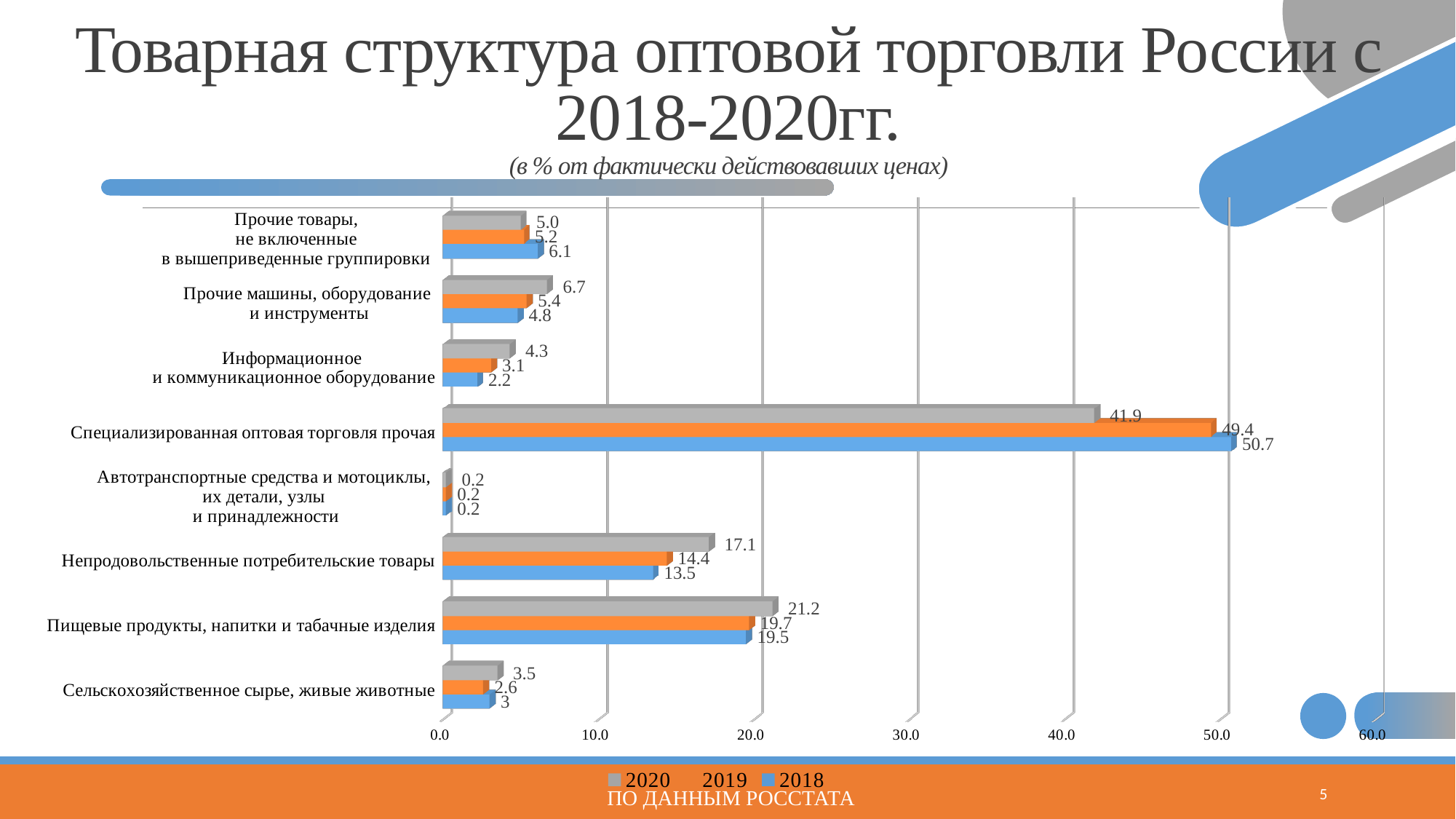
Which category has the highest 2018 value? Специализированная оптовая торговля прочая How many categories are shown on the chart? 8 What kind of chart is shown on the slide? Bar chart Which category has the lowest 2020 value? Автотранспортные средства и мотоциклы, их детали, узлы и принадлежности Is the 2020 value for Пищевые продукты, напитки и табачные изделия greater or less than 20.0? greater What is the 2020 value for Информационное и коммуникационное оборудование? 4.3 Which is larger for Прочие машины, оборудование и инструменты: the 2020 value or the 2018 value? 2020 What is the 2020 value for Специализированная оптовая торговля прочая? 41.9 What is the 2019 value for Непродовольственные потребительские товары? 14.4 What is the 2018 value for Пищевые продукты, напитки и табачные изделия? 19.5 What is the difference between the 2018 and 2020 values for Специализированная оптовая торговля прочая? 8.8 How many series does the legend list? 3